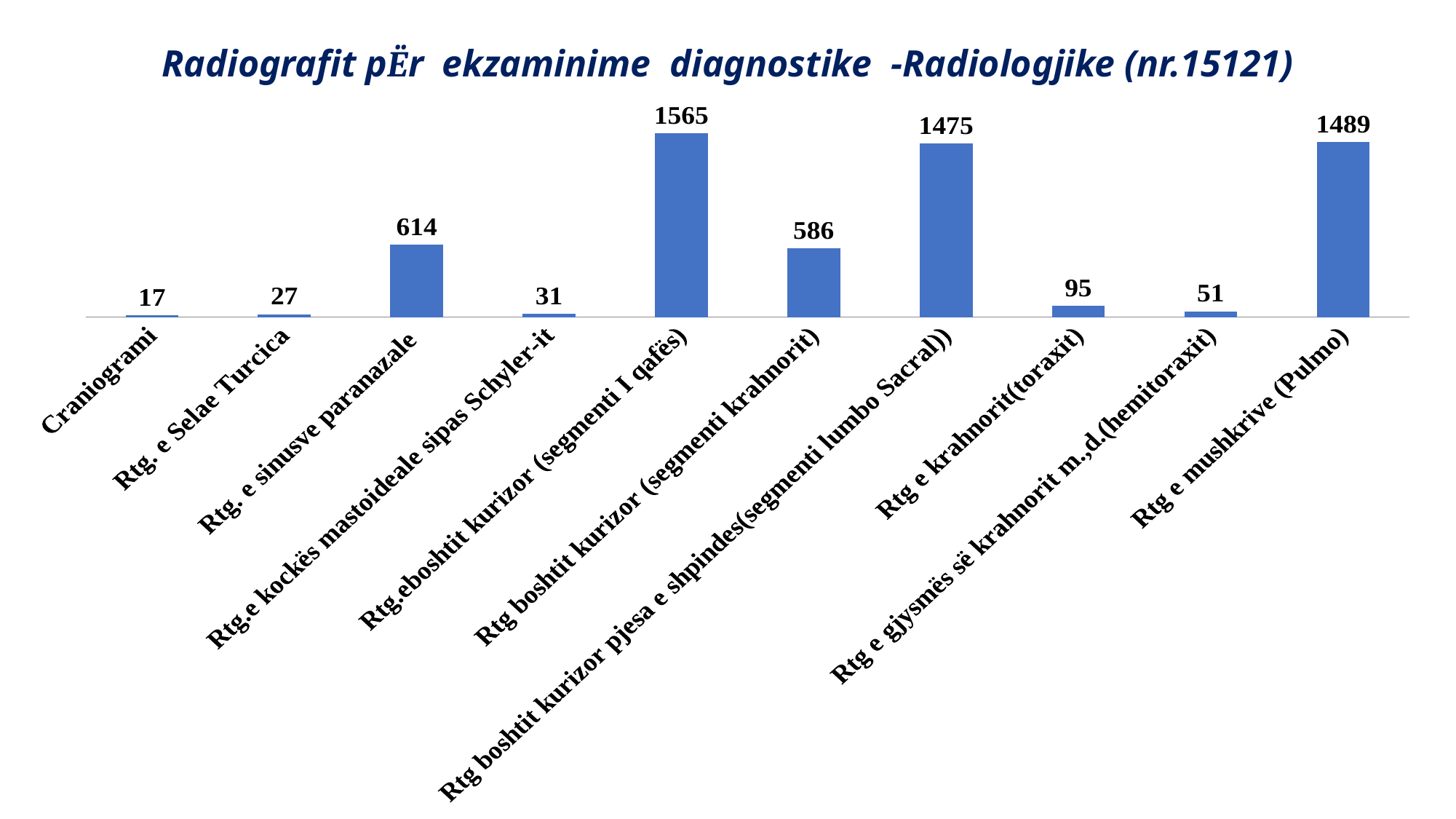
How many categories are shown in the chart? 10 What is the value for Rtg e mushkrive (Pulmo)? 1489 What is the value for Rtg. e sinusve paranazale? 614 What is the difference between the values for Rtg e gjysmës së krahnorit m.,d.(hemitoraxit) and Rtg. e Selae Turcica? 24 What is the difference between the values for Rtg.eboshtit kurizor (segmenti I qafës) and Rtg e mushkrive (Pulmo)? 76 Which category has the lowest value? Craniogrami What is the title of the chart? Radiografit pËr ekzaminime diagnostike -Radiologjike (nr.15121) What is the value for Craniogrami? 17 Which category has the highest value? Rtg.eboshtit kurizor (segmenti I qafës) What kind of chart is shown on the slide? Bar chart What is the value for Rtg e krahnorit(toraxit)? 95 Which is larger: the value for Rtg. e sinusve paranazale or the value for Rtg boshtit kurizor (segmenti krahnorit)? Rtg. e sinusve paranazale